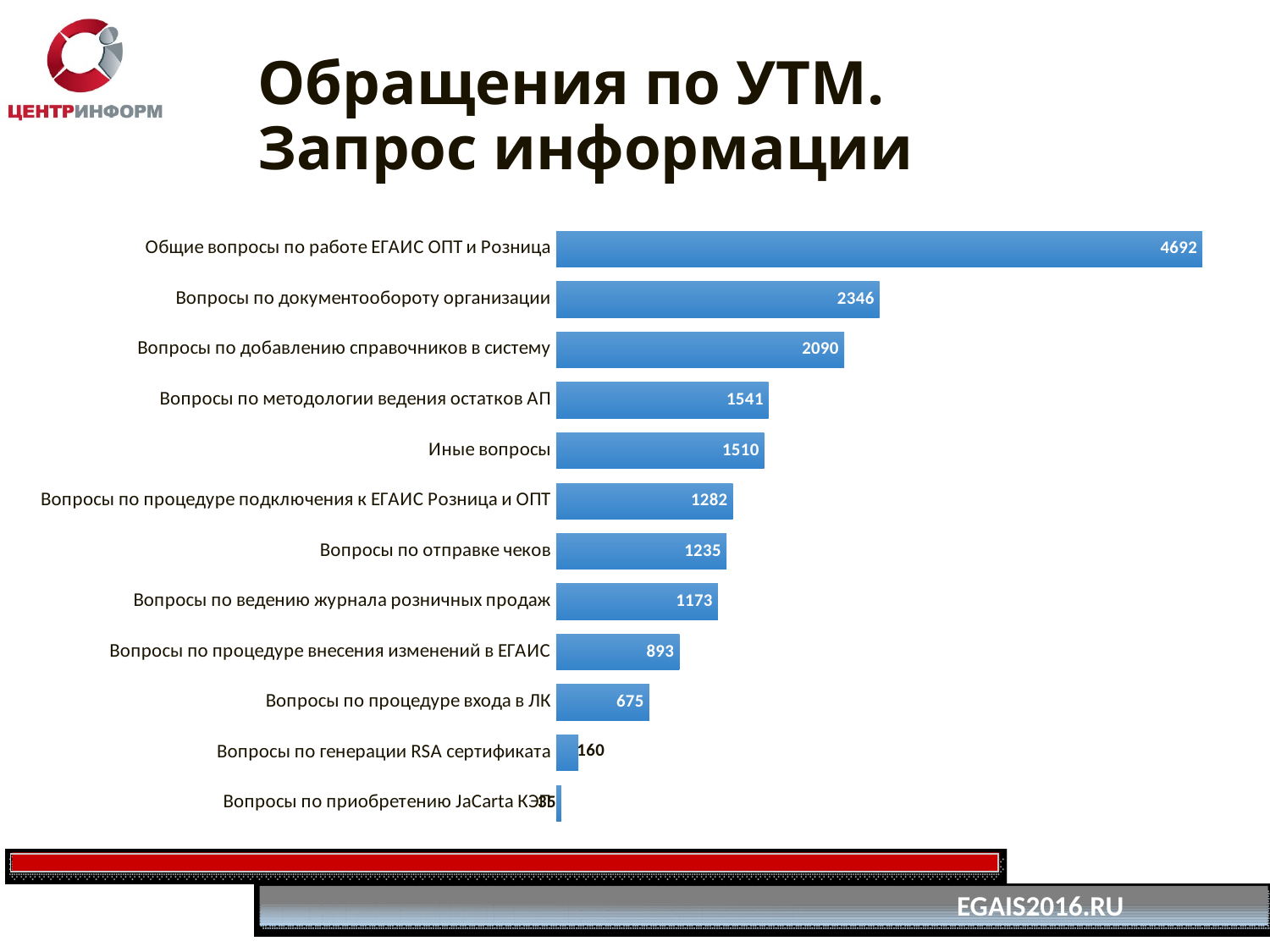
Which is larger: the value for "Вопросы по методологии ведения остатков АП" or the value for "Вопросы по процедуре внесения изменений в ЕГАИС"? Вопросы по методологии ведения остатков АП Which category has the highest value? Общие вопросы по работе ЕГАИС ОПТ и Розница What is the difference between the values for "Общие вопросы по работе ЕГАИС ОПТ и Розница" and "Вопросы по документообороту организации"? 2346 What is the difference between the values for "Вопросы по документообороту организации" and "Вопросы по добавлению справочников в систему"? 256 What is the title of the slide containing the chart? Обращения по УТМ. Запрос информации How many categories are plotted in the chart? 12 What is the value for "Вопросы по документообороту организации"? 2346 What is the value for "Общие вопросы по работе ЕГАИС ОПТ и Розница"? 4692 What kind of chart is shown on the slide? bar chart What is the value for "Вопросы по генерации RSA сертификата"? 160 What is the value for "Вопросы по процедуре входа в ЛК"? 675 What is the value for "Вопросы по отправке чеков"? 1235